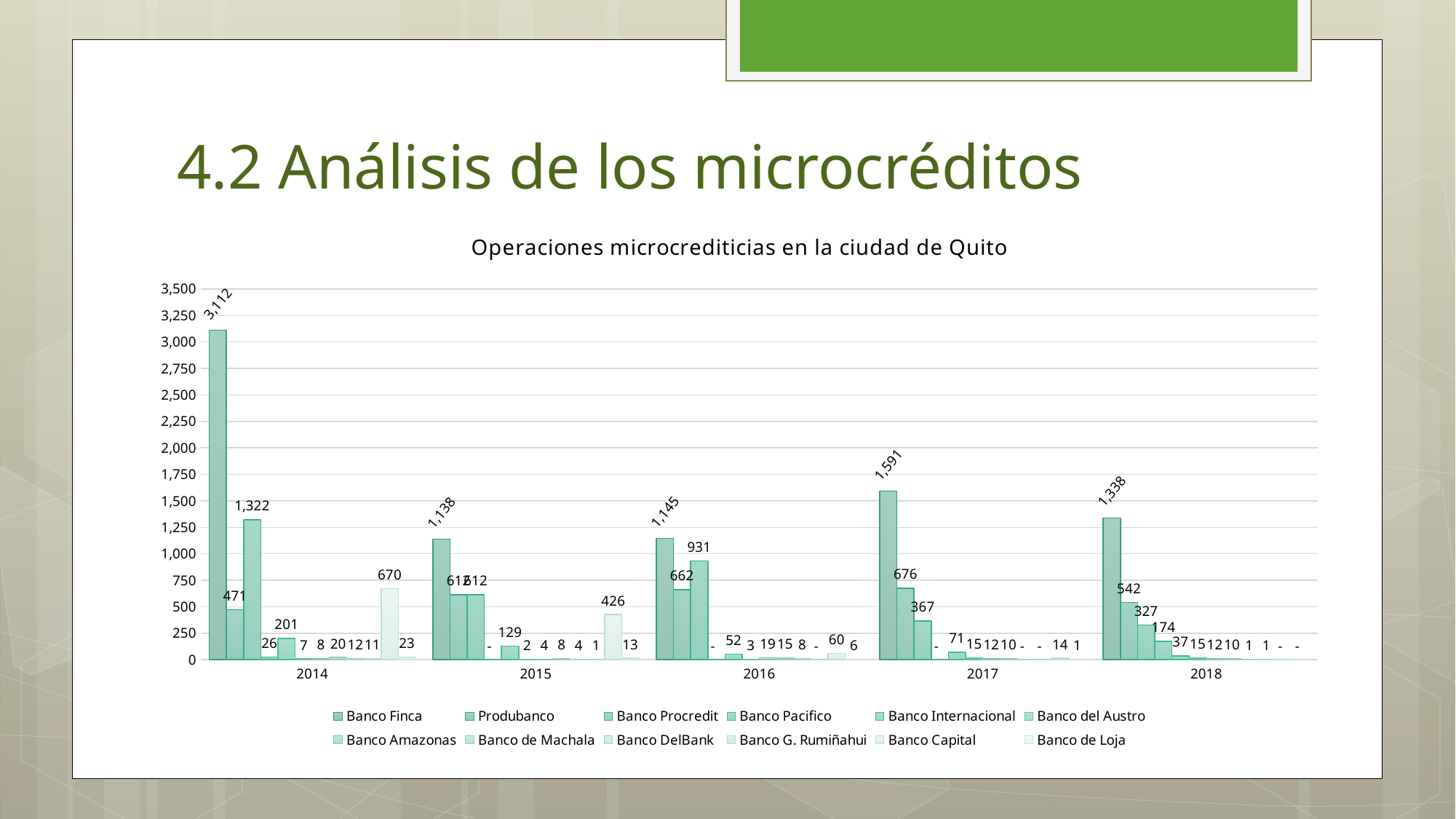
What is the difference between the Banco Finca values for 2014 and 2018? 1,774 What is the title of the chart? Operaciones microcrediticias en la ciudad de Quito In which year is the value for Banco Finca highest? 2014 How many years are shown on the x axis? 5 Is the value for Banco Finca in 2015 greater or less than 1,000? greater What is the value for Banco Finca in 2014? 3,112 What kind of chart is shown on the slide? bar chart What is the value for Banco Finca in 2017? 1,591 How many series does the legend list? 12 Which is larger in 2016, the value for Produbanco or the value for Banco Procredit? Banco Procredit What is the value for Banco Capital in 2014? 670 What is the value for Banco Procredit in 2016? 931